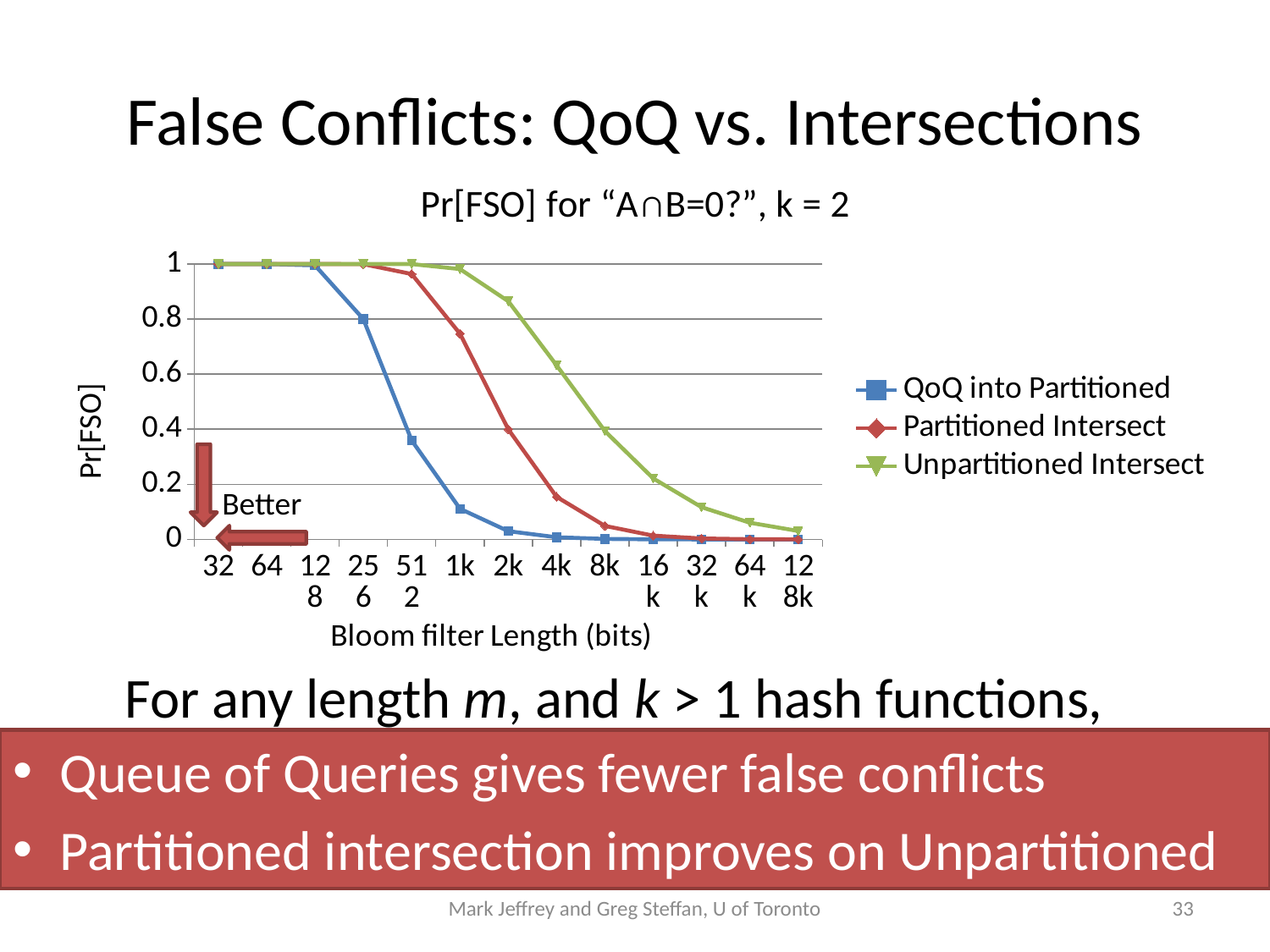
What is the label of the x axis of the chart? Bloom filter Length (bits) Is the value for QoQ into Partitioned at 512 bits greater or less than 0.6? less How many series does the legend list? 3 What kind of chart is shown on the slide? line chart Is the value for Unpartitioned Intersect at 2k bits greater or less than 0.8? greater Is the value for Unpartitioned Intersect at 32k bits greater or less than 0.2? less At 4k bits, which series has the lower Pr[FSO]: Partitioned Intersect or Unpartitioned Intersect? Partitioned Intersect At 1k bits, which series has the higher Pr[FSO]: QoQ into Partitioned or Unpartitioned Intersect? Unpartitioned Intersect Do the Pr[FSO] values rise or fall as the Bloom filter length increases along the x axis? fall How many Bloom filter length categories are shown on the x axis? 13